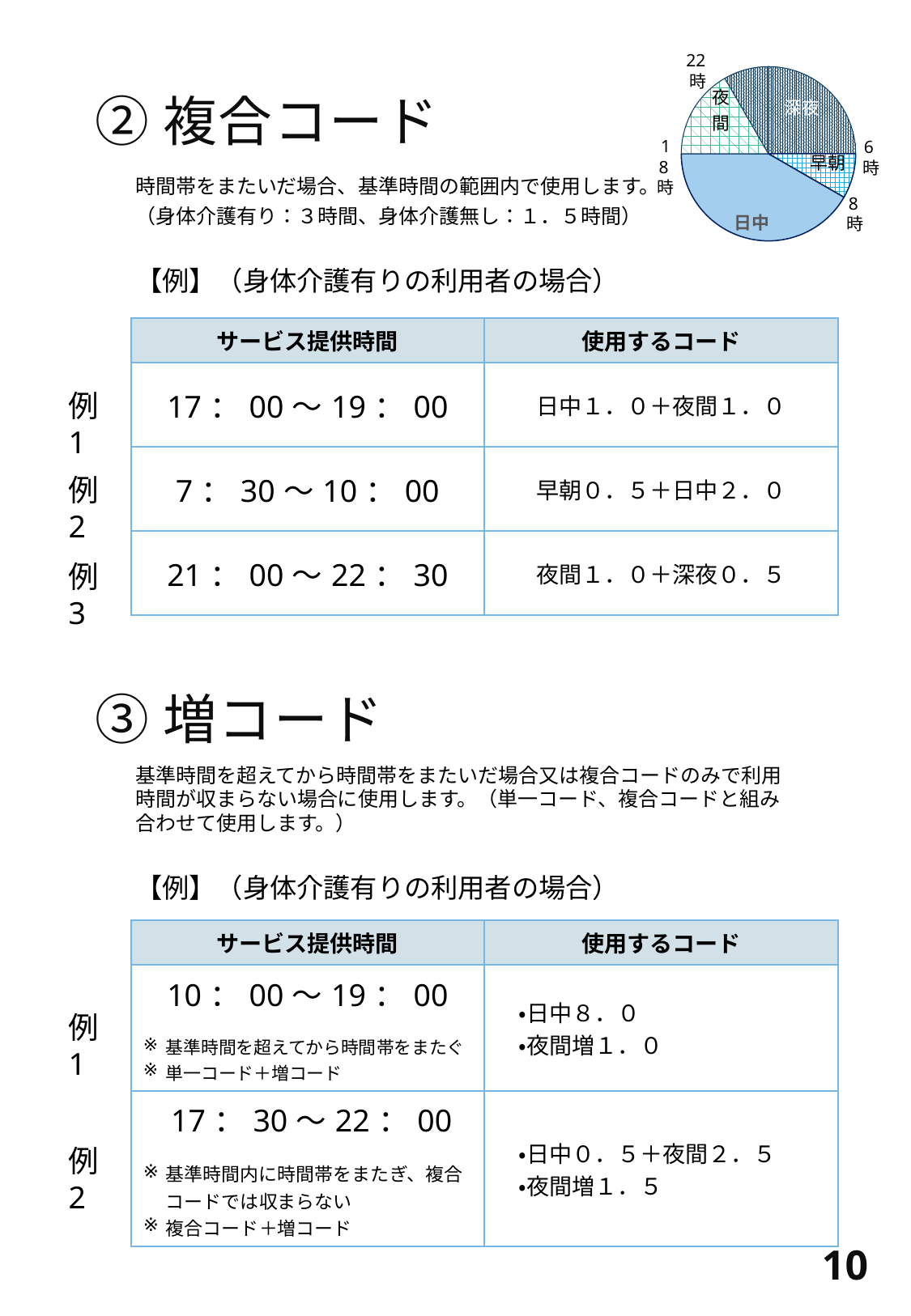
In the pie chart, which slice is larger, 深夜 or 早朝? 深夜 What are the four time-band labels shown on the pie chart? 深夜, 早朝, 日中, 夜間 According to the pie chart, at what time does the 日中 band end and the 夜間 band begin? 18時 According to the pie chart, at what time does the 日中 band begin? 8時 What kind of chart is shown in the top right of the slide? pie chart In the pie chart, which slice is larger, 日中 or 夜間? 日中 How many slices does the pie chart have? 5 According to the pie chart, at what time does the 深夜 band begin? 22時 In the pie chart, which slice is larger, 深夜 or 夜間? 深夜 According to the pie chart, at what time does the 早朝 band begin? 6時 Which slice of the pie chart is the largest? 日中